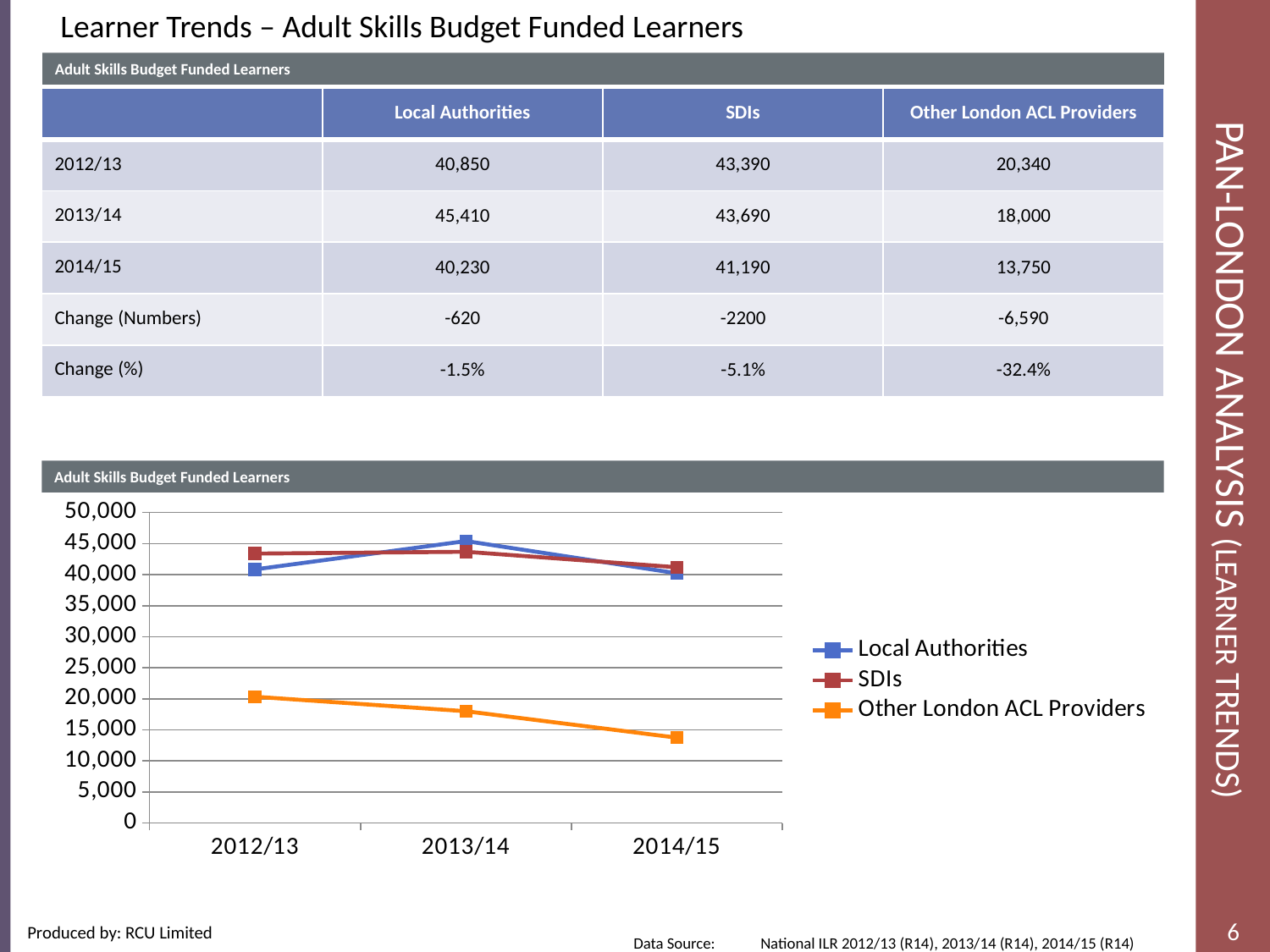
What is the title of the chart? Adult Skills Budget Funded Learners Which series has the highest value in 2013/14? Local Authorities Is the value for Other London ACL Providers in 2014/15 greater or less than 15,000? less Does the Other London ACL Providers line rise or fall from 2012/13 to 2014/15? fall What kind of chart is shown on the slide? line chart Is the value for SDIs in 2012/13 greater or less than 40,000? greater Which series has the lowest values across all three years in the chart? Other London ACL Providers How many years are plotted along the x axis of the chart? 3 What is the value for Other London ACL Providers in 2012/13? 20,340 How many series does the chart's legend list? 3 In 2012/13, which is larger: the value for SDIs or the value for Local Authorities? SDIs Is the value for Local Authorities in 2013/14 greater or less than 45,000? greater